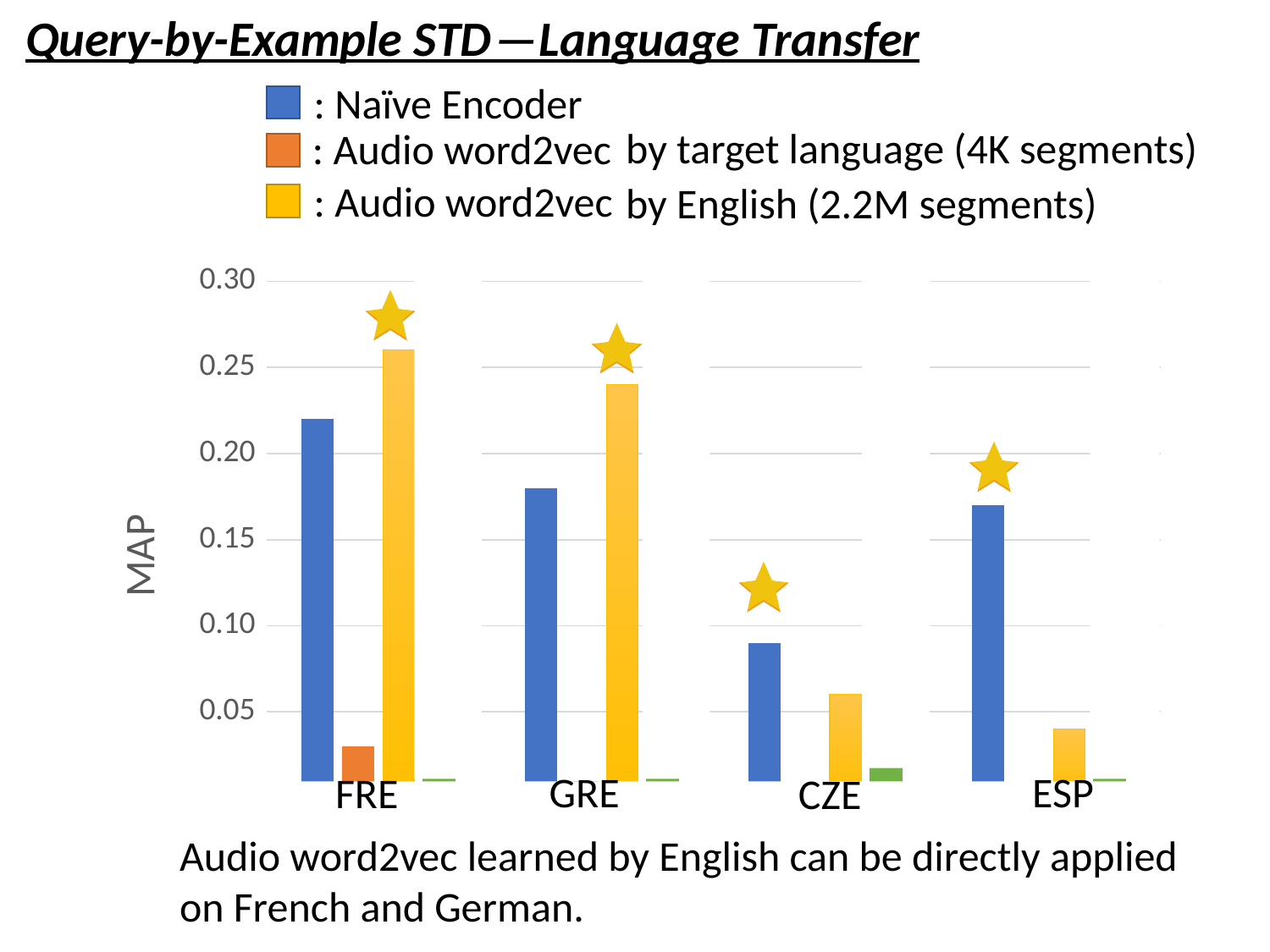
Which language has the highest MAP for Audio word2vec by English (2.2M segments)? FRE Is the MAP of Audio word2vec by English (2.2M segments) for ESP greater or less than 0.05? less What is the label of the y axis of the chart? MAP Is the MAP of the Naïve Encoder for CZE greater or less than 0.10? less For CZE, which is larger: the MAP of the Naïve Encoder or of Audio word2vec by English (2.2M segments)? Naïve Encoder Which language has the highest MAP for the Naïve Encoder? FRE Which language has the lowest MAP for the Naïve Encoder? CZE What kind of chart is shown on the slide? bar chart How many series does the legend above the chart list? 3 Is the MAP of the Naïve Encoder for FRE greater or less than 0.20? greater How many languages (categories) are shown on the x axis of the chart? 4 For FRE, which is larger: the MAP of the Naïve Encoder or of Audio word2vec by English (2.2M segments)? Audio word2vec by English (2.2M segments)